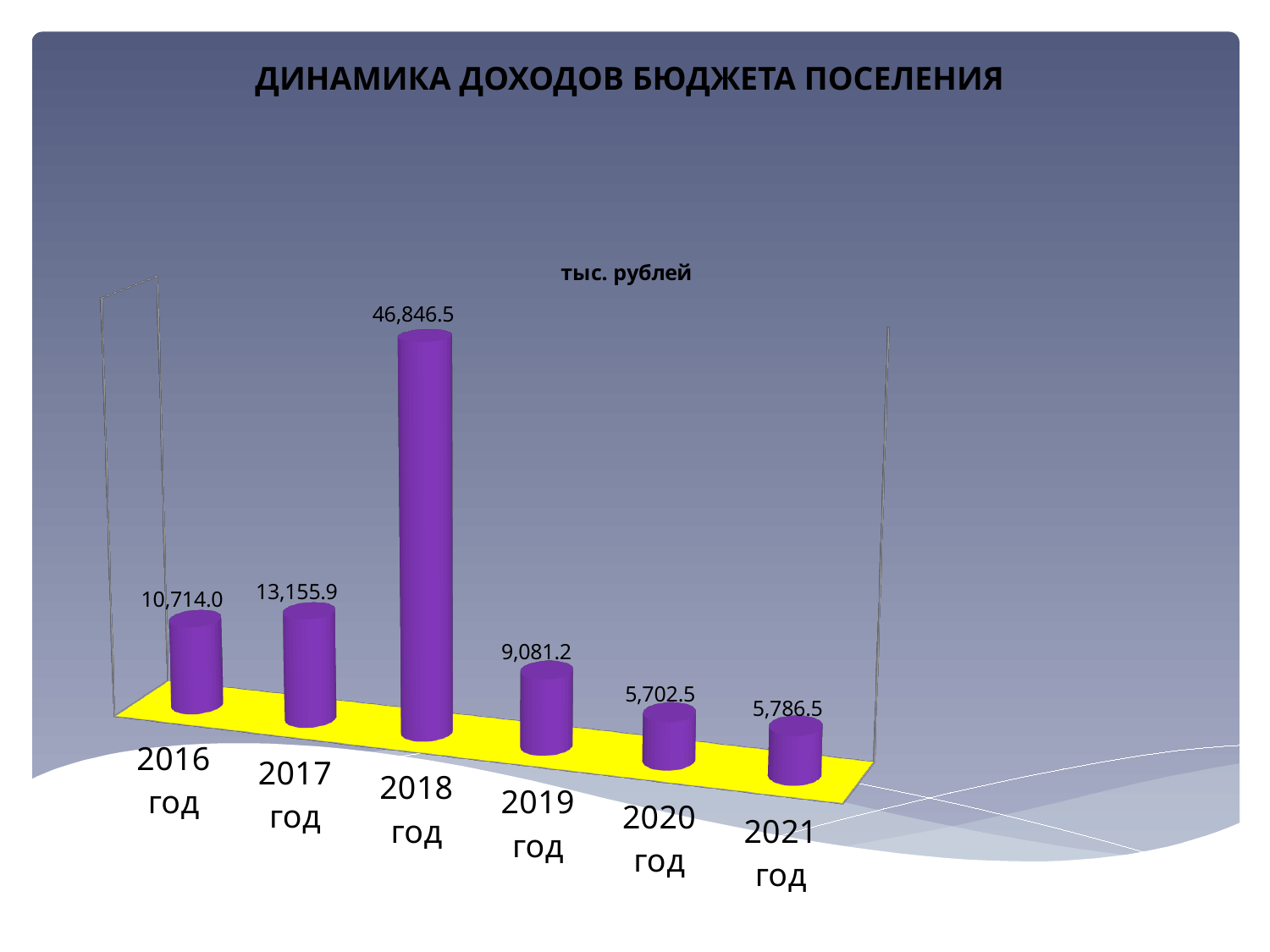
What is the value for 2020 год? 5,702.5 What is the title of the chart? тыс. рублей What is the difference between the values for 2017 год and 2016 год? 2,441.9 Which year has the lowest value? 2020 год Which is larger, the value for 2016 год or the value for 2019 год? 2016 год What kind of chart is this? bar chart What is the value for 2021 год? 5,786.5 What is the difference between the values for 2018 год and 2017 год? 33,690.6 What is the value for 2018 год? 46,846.5 How many years are shown on the chart? 6 What is the value for 2016 год? 10,714.0 Which year has the highest value? 2018 год